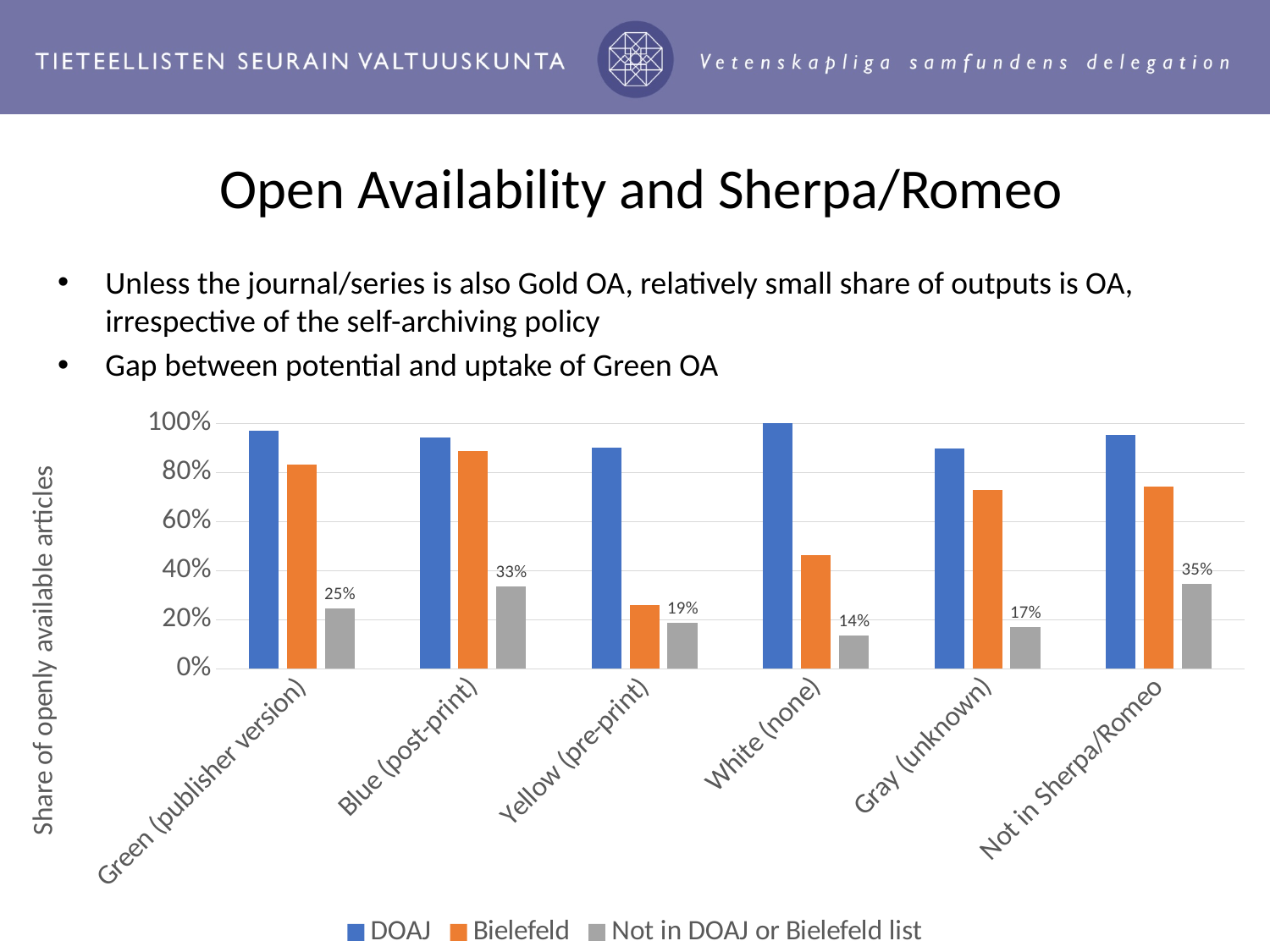
How many categories are shown on the x axis? 6 What is the title of the vertical axis? Share of openly available articles What is the value for Not in DOAJ or Bielefeld list in the White (none) category? 14% Is the DOAJ value for White (none) greater or less than 80%? greater Is the Bielefeld value for Yellow (pre-print) greater or less than 40%? less Which category has the highest value for the Not in DOAJ or Bielefeld list series? Not in Sherpa/Romeo How many series does the legend list? 3 Which category has the lowest value for the Not in DOAJ or Bielefeld list series? White (none) What is the value for Not in DOAJ or Bielefeld list in the Green (publisher version) category? 25% For the Not in DOAJ or Bielefeld list series, which is larger: Blue (post-print) or Yellow (pre-print)? Blue (post-print) What is the value for Not in DOAJ or Bielefeld list in the Not in Sherpa/Romeo category? 35% What is the difference between the Not in DOAJ or Bielefeld list values for Blue (post-print) and Green (publisher version)? 8 percentage points